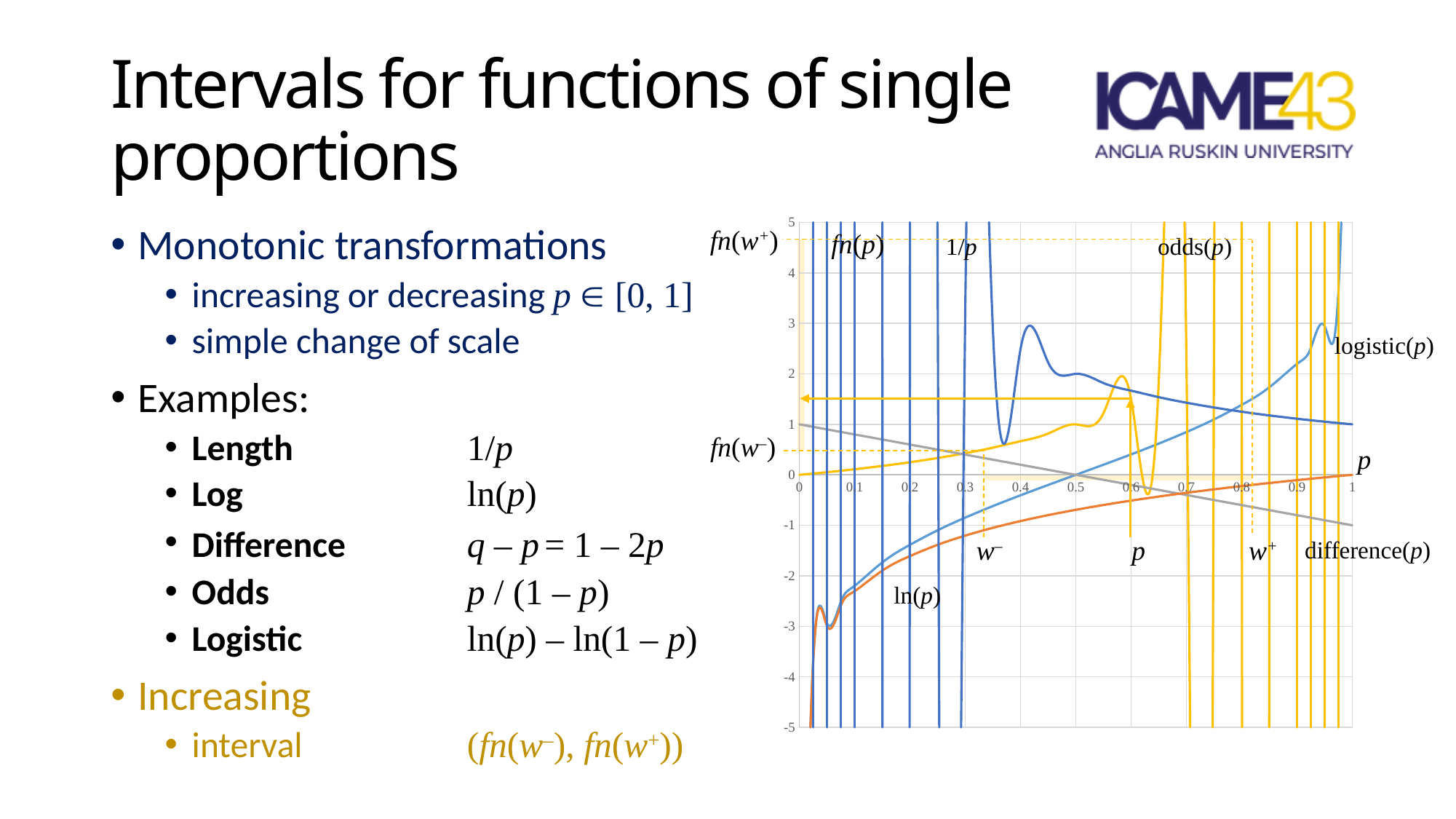
Does the logistic(p) curve rise or fall as p increases from 0.5 to 1? rise Does the ln(p) curve rise or fall as p increases from 0 to 1? rise Is the value of ln(p) at p = 0.2 greater or less than -1? less How many named functions are labelled on the chart (fn(p), 1/p, odds(p), logistic(p), ln(p), difference(p))? 6 Is the position of w⁻ on the x axis greater or less than 0.5? less What kind of chart is shown on the right of the slide? line chart Is the value of difference(p) at p = 0.9 greater or less than 0? less At what value of p does the difference(p) line cross zero? 0.5 What is the lowest value shown on the y axis of the chart? -5 Does the difference(p) line rise or fall as p increases from 0 to 1? fall What is the highest value shown on the y axis of the chart? 5